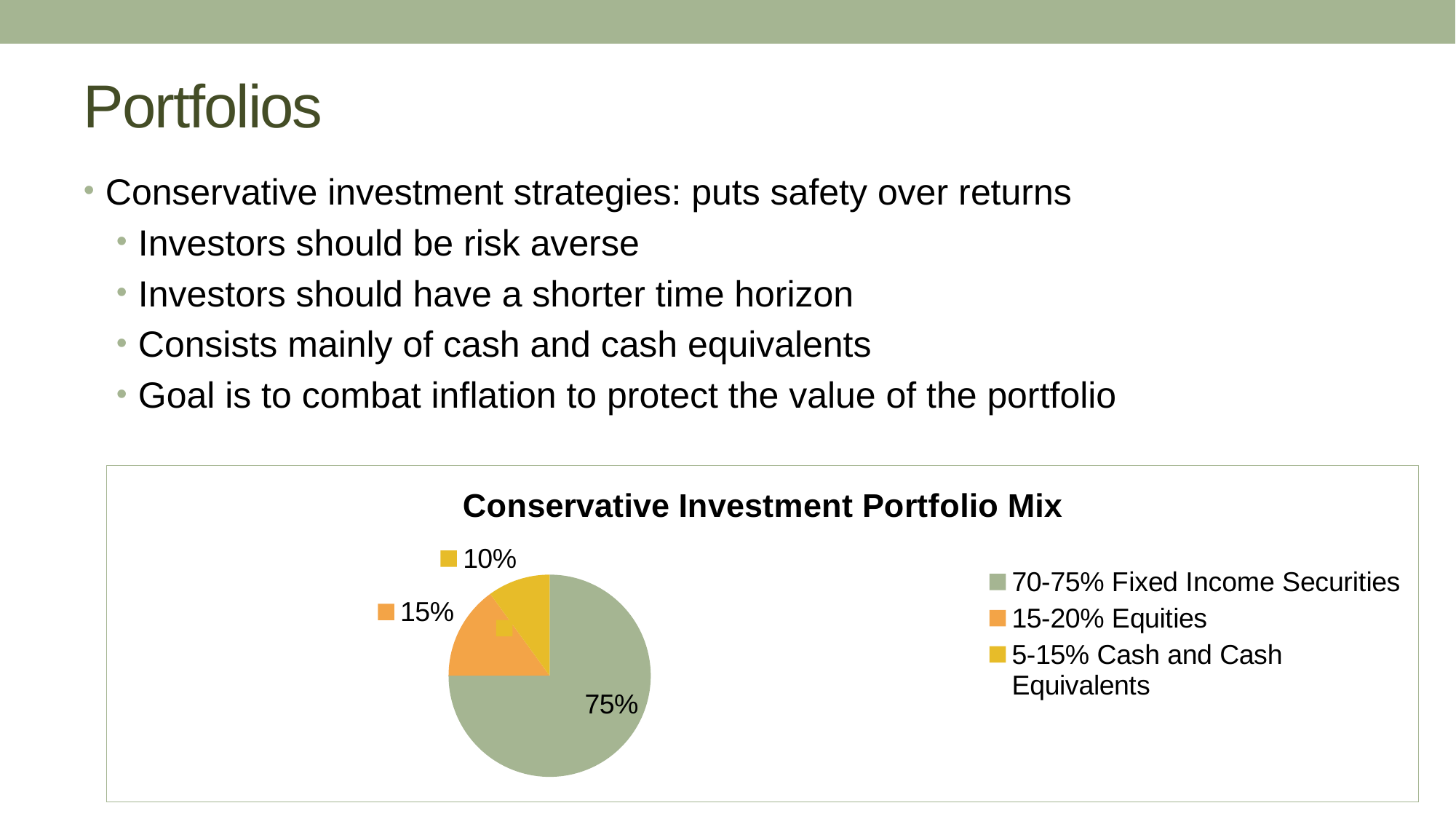
What is the difference between the Equities share and the Cash and Cash Equivalents share? 5% How many slices does the pie chart have? 3 Which slice of the pie is the smallest? 5-15% Cash and Cash Equivalents What kind of chart is shown on the slide? pie chart Which is larger, the Equities slice or the Cash and Cash Equivalents slice? Equities What share of the pie is labelled for the 70-75% Fixed Income Securities slice? 75% Which slice of the pie is the largest? 70-75% Fixed Income Securities What share of the pie is labelled for the 15-20% Equities slice? 15% How many entries does the legend list? 3 What share of the pie is labelled for the 5-15% Cash and Cash Equivalents slice? 10% What is the difference between the Fixed Income Securities share and the Equities share? 60% What is the title of the chart? Conservative Investment Portfolio Mix